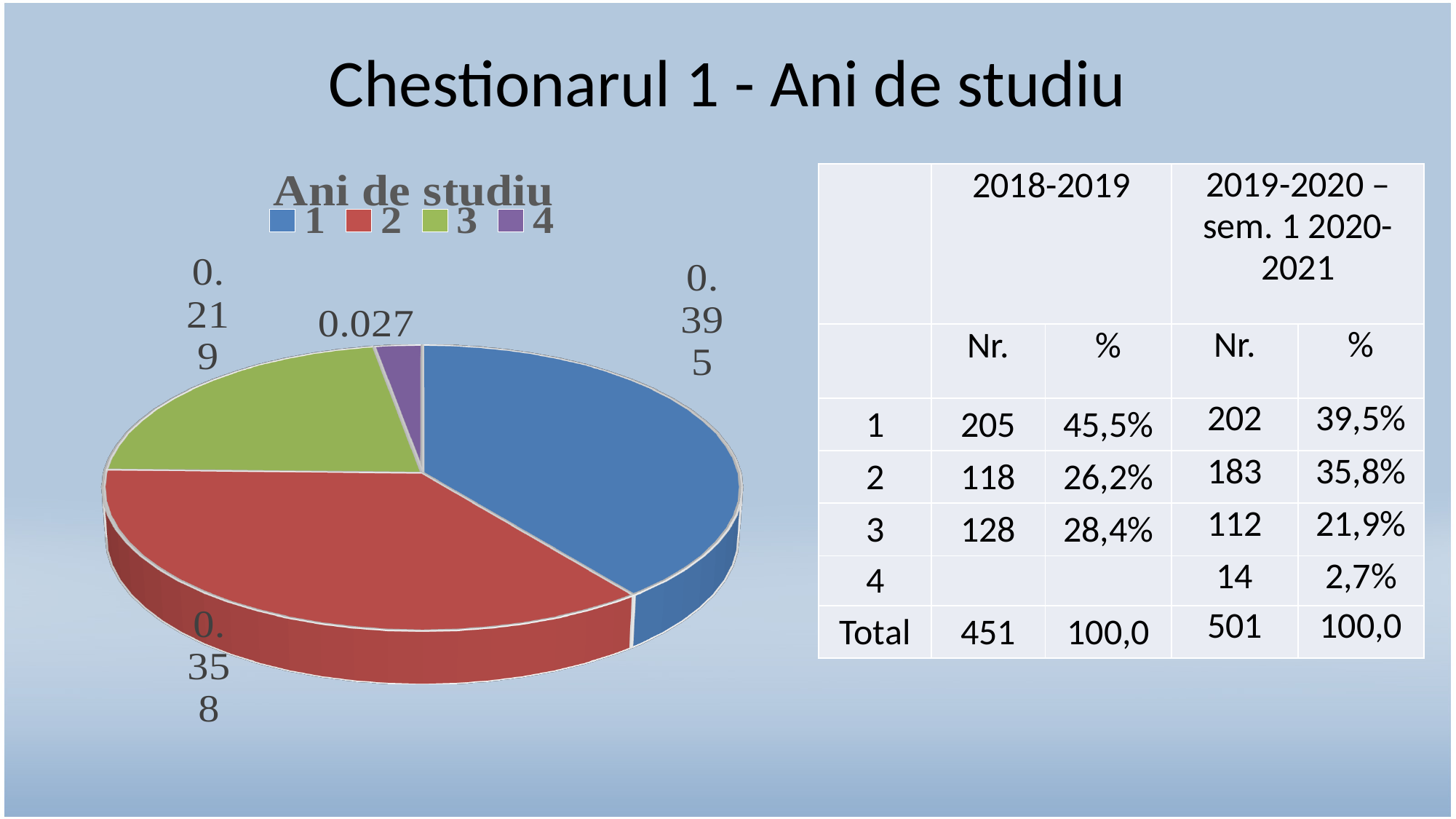
Which category has the smallest slice in the pie chart? 4 Which is larger in the pie chart, the value for category 2 or category 3? category 2 What is the title of the chart? Ani de studiu How many entries does the chart legend list? 4 What is the data label for category 3 in the pie chart? 0.219 What kind of chart is shown on the slide? pie chart What is the data label for category 4 in the pie chart? 0.027 What is the data label for category 1 in the pie chart? 0.395 Which category has the largest slice in the pie chart? 1 What is the data label for category 2 in the pie chart? 0.358 What colour is the slice for category 3 in the pie chart? green How many slices does the pie chart have? 4